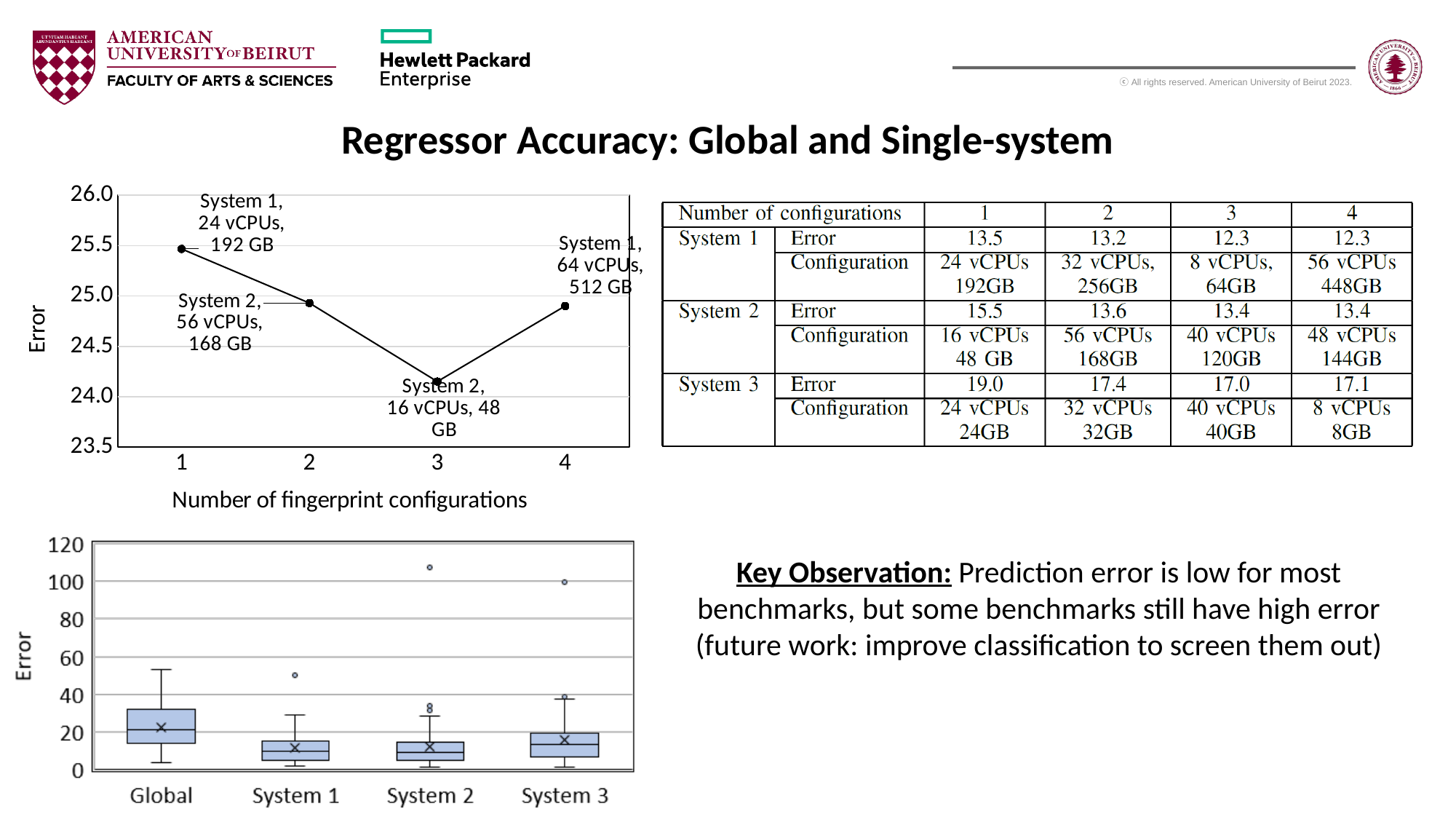
In the top-left line chart, at which number of fingerprint configurations is the error lowest? 3 In the top-left line chart, at which number of fingerprint configurations is the error highest? 1 In the top-left line chart, is the error at 3 fingerprint configurations greater or less than 24.5? less In the top-left line chart, what is the label on the x axis? Number of fingerprint configurations In the top-left line chart, how many data points are plotted? 4 In the bottom-left box plot, is the highest outlier for System 2 greater or less than 100? greater What kind of chart is the bottom-left chart? box plot In the top-left line chart, does the error rise or fall from 1 to 3 fingerprint configurations? fall In the top-left line chart, which configuration is annotated at the point for 3 fingerprint configurations? System 2, 16 vCPUs, 48 GB In the top-left line chart, is the error at 2 fingerprint configurations greater or less than 24.5? greater In the bottom-left box plot, how many categories are shown on the x axis? 4